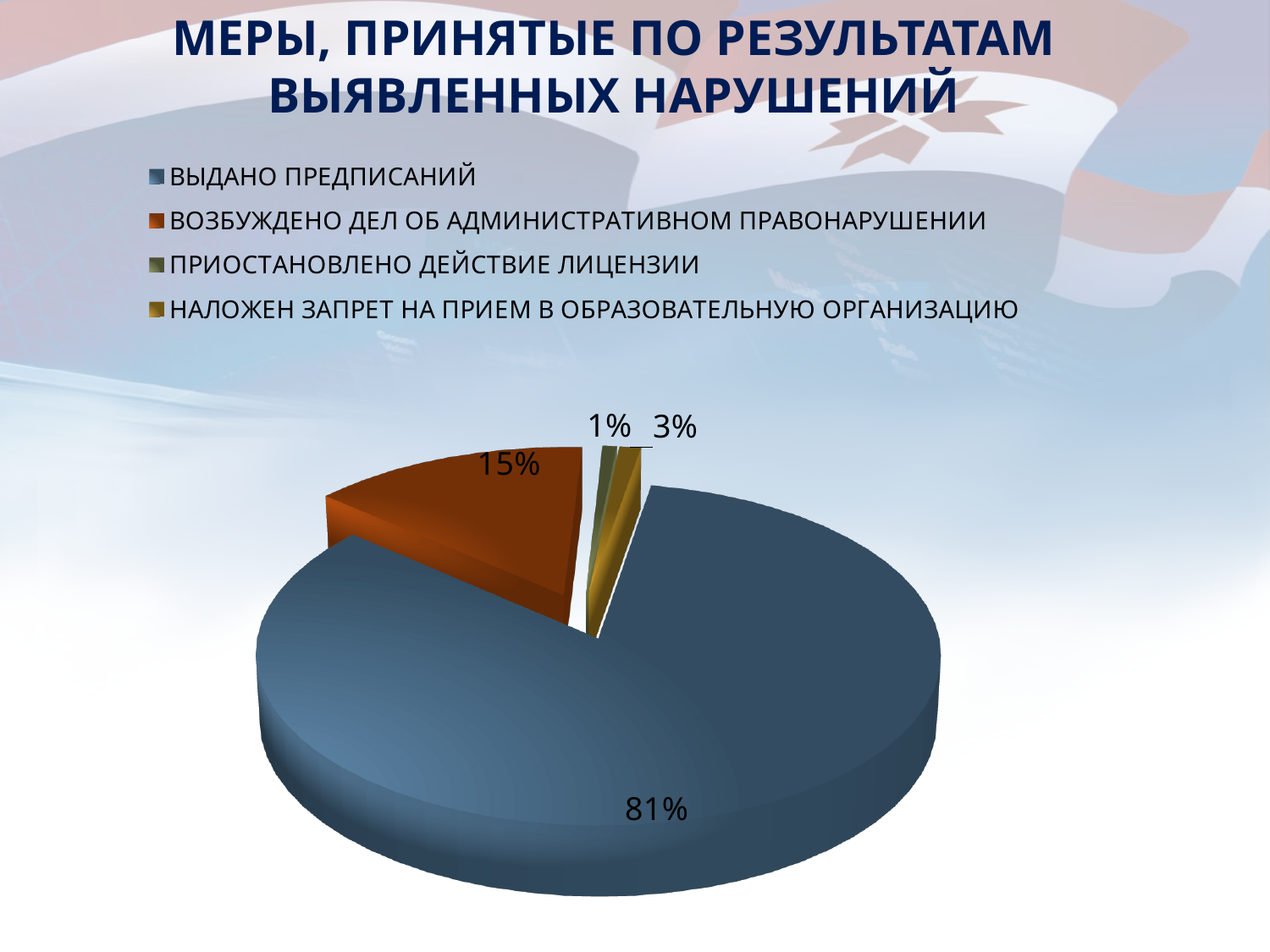
What kind of chart is shown on the slide? pie chart Which is larger: the slice for "НАЛОЖЕН ЗАПРЕТ НА ПРИЕМ В ОБРАЗОВАТЕЛЬНУЮ ОРГАНИЗАЦИЮ" or the slice for "ПРИОСТАНОВЛЕНО ДЕЙСТВИЕ ЛИЦЕНЗИИ"? НАЛОЖЕН ЗАПРЕТ НА ПРИЕМ В ОБРАЗОВАТЕЛЬНУЮ ОРГАНИЗАЦИЮ What share of the pie does "ВОЗБУЖДЕНО ДЕЛ ОБ АДМИНИСТРАТИВНОМ ПРАВОНАРУШЕНИИ" have? 15% How many categories does the pie chart have? 4 What share of the pie does "ПРИОСТАНОВЛЕНО ДЕЙСТВИЕ ЛИЦЕНЗИИ" have? 1% What is the title of the slide containing the chart? МЕРЫ, ПРИНЯТЫЕ ПО РЕЗУЛЬТАТАМ ВЫЯВЛЕННЫХ НАРУШЕНИЙ Which category has the smallest slice of the pie? ПРИОСТАНОВЛЕНО ДЕЙСТВИЕ ЛИЦЕНЗИИ What share of the pie does "НАЛОЖЕН ЗАПРЕТ НА ПРИЕМ В ОБРАЗОВАТЕЛЬНУЮ ОРГАНИЗАЦИЮ" have? 3% Which category has the largest slice of the pie? ВЫДАНО ПРЕДПИСАНИЙ What is the difference in percentage points between the "ВЫДАНО ПРЕДПИСАНИЙ" slice and the "ВОЗБУЖДЕНО ДЕЛ ОБ АДМИНИСТРАТИВНОМ ПРАВОНАРУШЕНИИ" slice? 66 Which colour represents "ВОЗБУЖДЕНО ДЕЛ ОБ АДМИНИСТРАТИВНОМ ПРАВОНАРУШЕНИИ" in the pie chart? orange